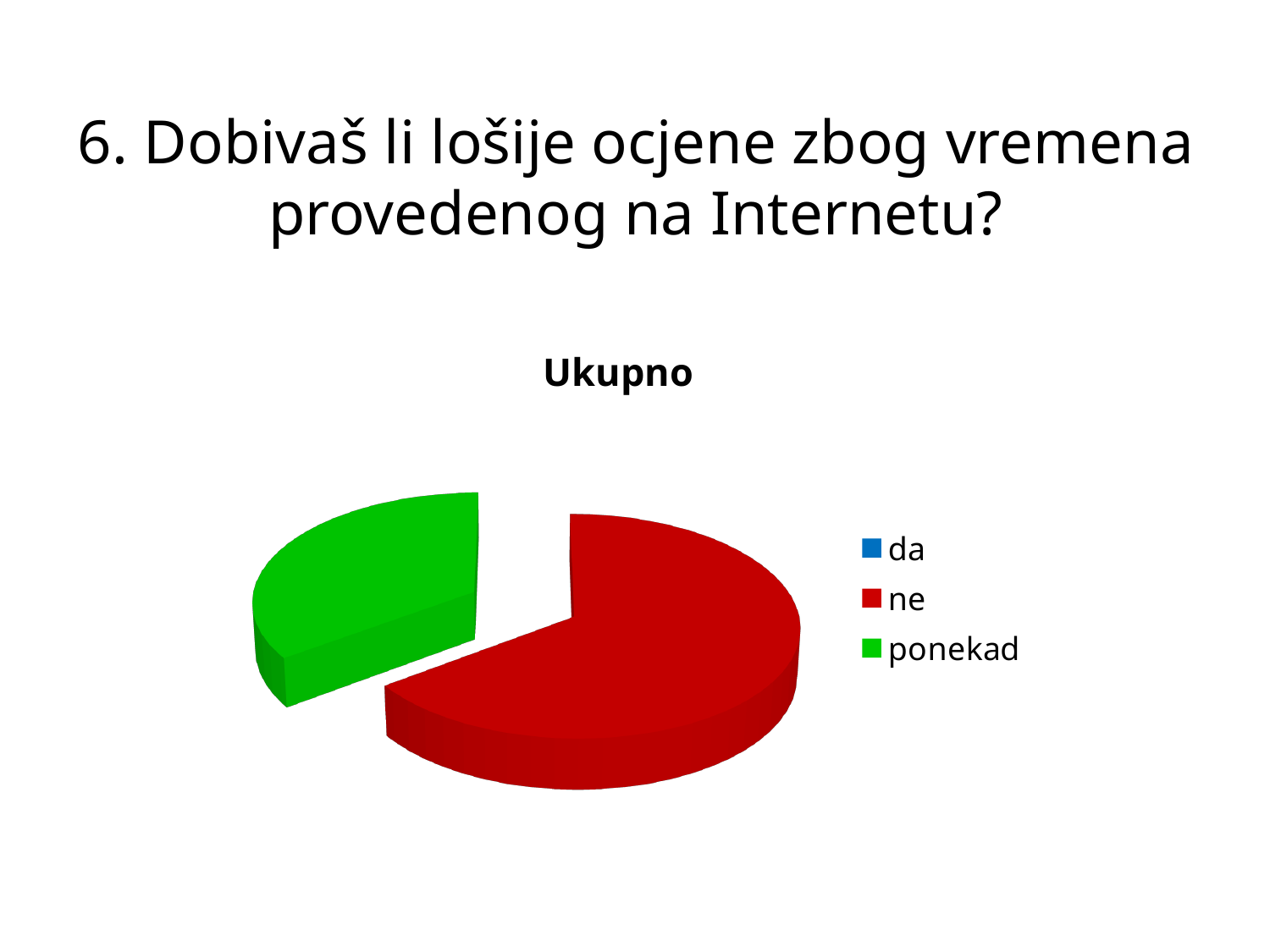
Which slice is larger, "ne" or "ponekad"? ne What kind of chart is shown on the slide? pie chart Does the "ne" slice take up more or less than half of the pie? more What is the title of the chart? Ukupno How many entries does the chart's legend list? 3 Which category has the largest slice of the pie? ne Which colour represents the "ponekad" category in the chart? green